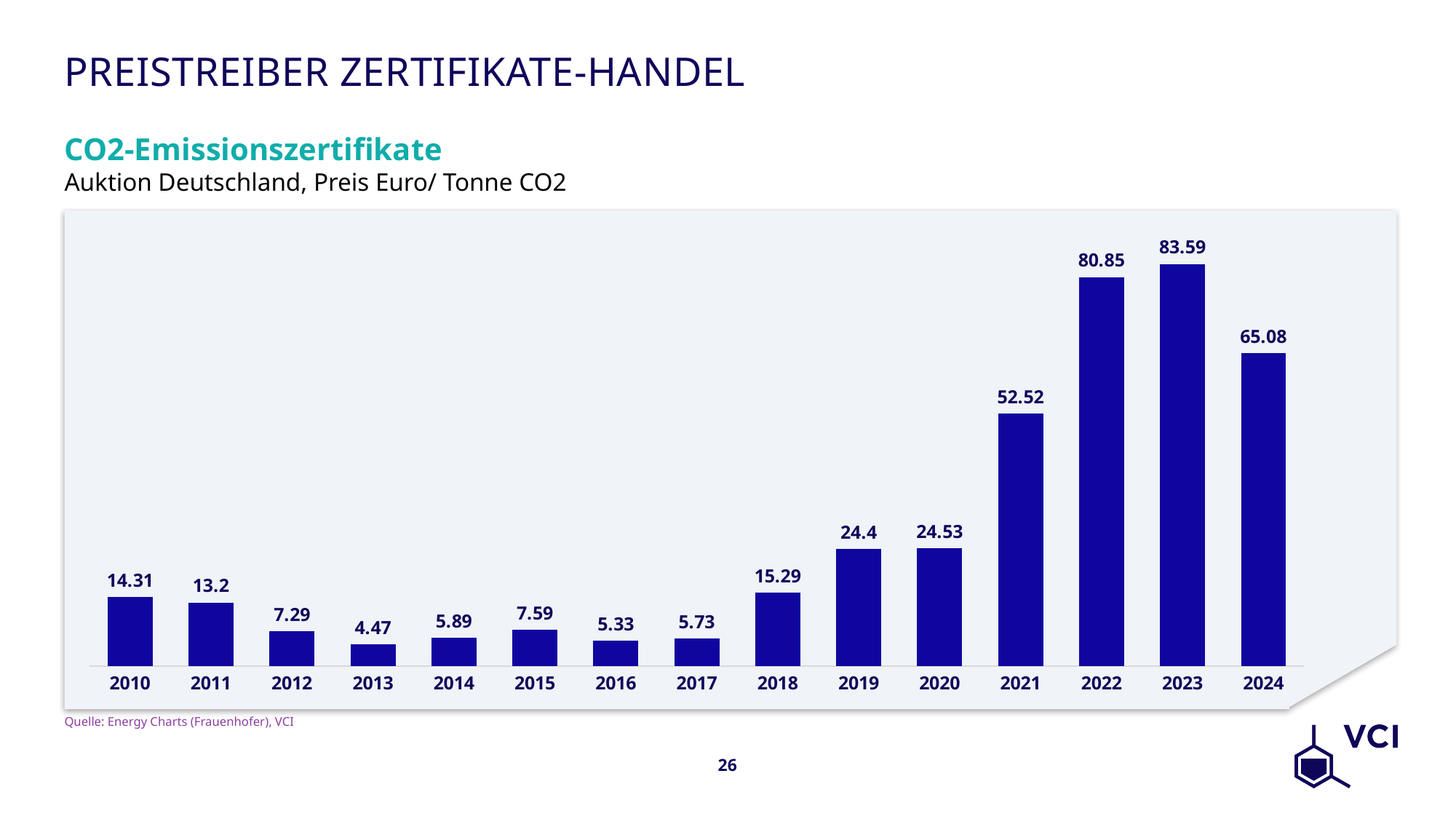
What is the difference between the values for 2023 and 2022? 2.74 How many years are shown on the x axis? 15 What is the value for 2024? 65.08 Which is larger, the value for 2010 or the value for 2011? 2010 Which year has the lowest value? 2013 What kind of chart is shown on the slide? Bar chart Which year has the highest value? 2023 What is the value for 2021? 52.52 What is the source cited below the chart? Energy Charts (Frauenhofer), VCI What is the value for 2013? 4.47 What is the difference between the values for 2022 and 2024? 15.77 Which is larger, the value for 2015 or the value for 2016? 2015